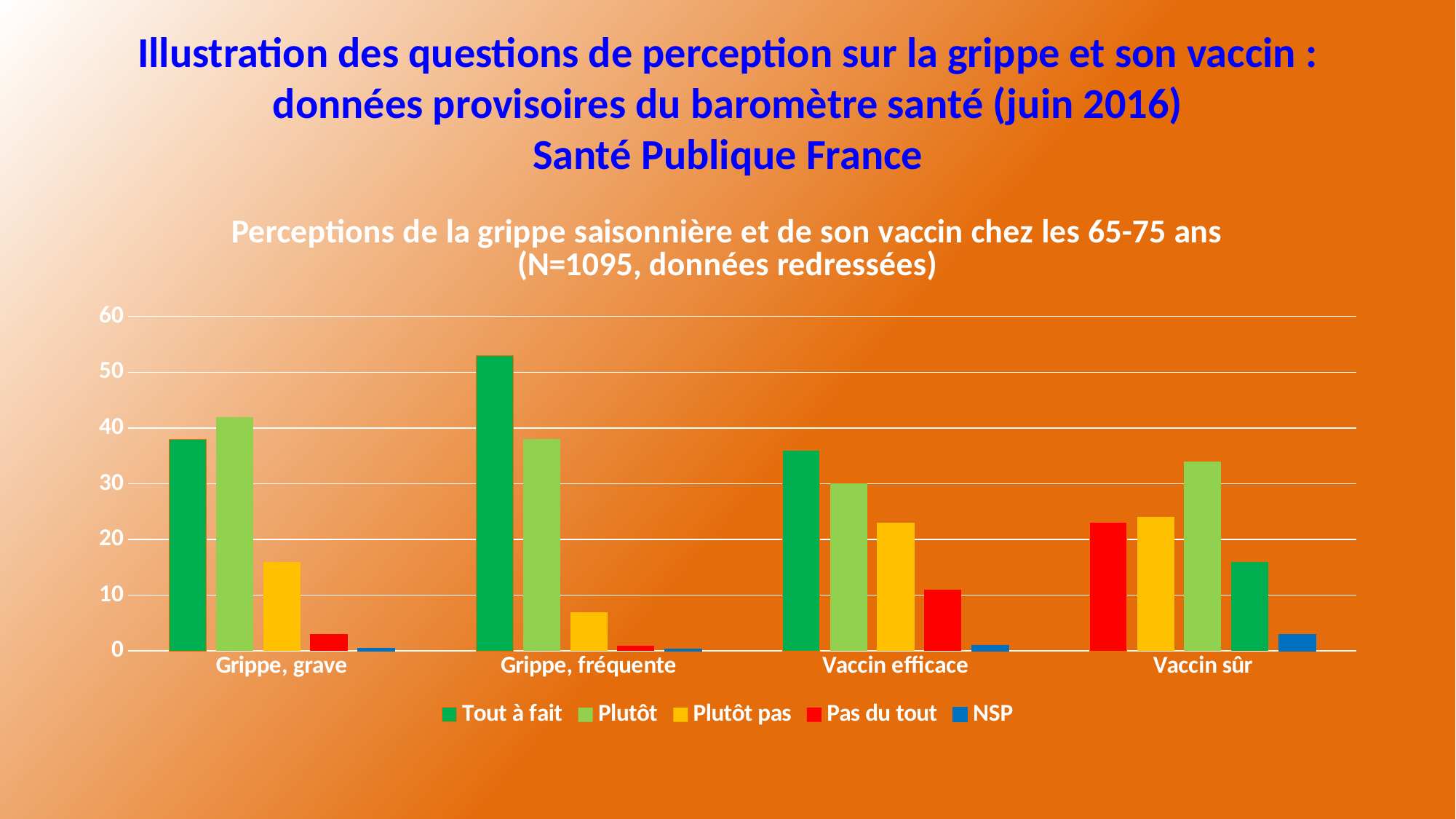
Which category has the lowest 'Pas du tout' bar? Grippe, fréquente Which category has the highest 'Tout à fait' bar? Grippe, fréquente How many series does the legend of the chart list? 5 For 'Grippe, grave', which is larger: the 'Tout à fait' bar or the 'Plutôt' bar? Plutôt Which is larger: the 'Tout à fait' value for 'Vaccin efficace' or for 'Vaccin sûr'? Vaccin efficace How many categories are shown on the x axis of the chart? 4 Which category has the highest 'Pas du tout' bar? Vaccin sûr What kind of chart is shown on the slide? bar chart Is the 'Plutôt pas' value for 'Grippe, grave' greater or less than 20? less What is the sample size (N) stated in the chart title? 1095 Is the 'Tout à fait' value for 'Grippe, fréquente' greater or less than 50? greater